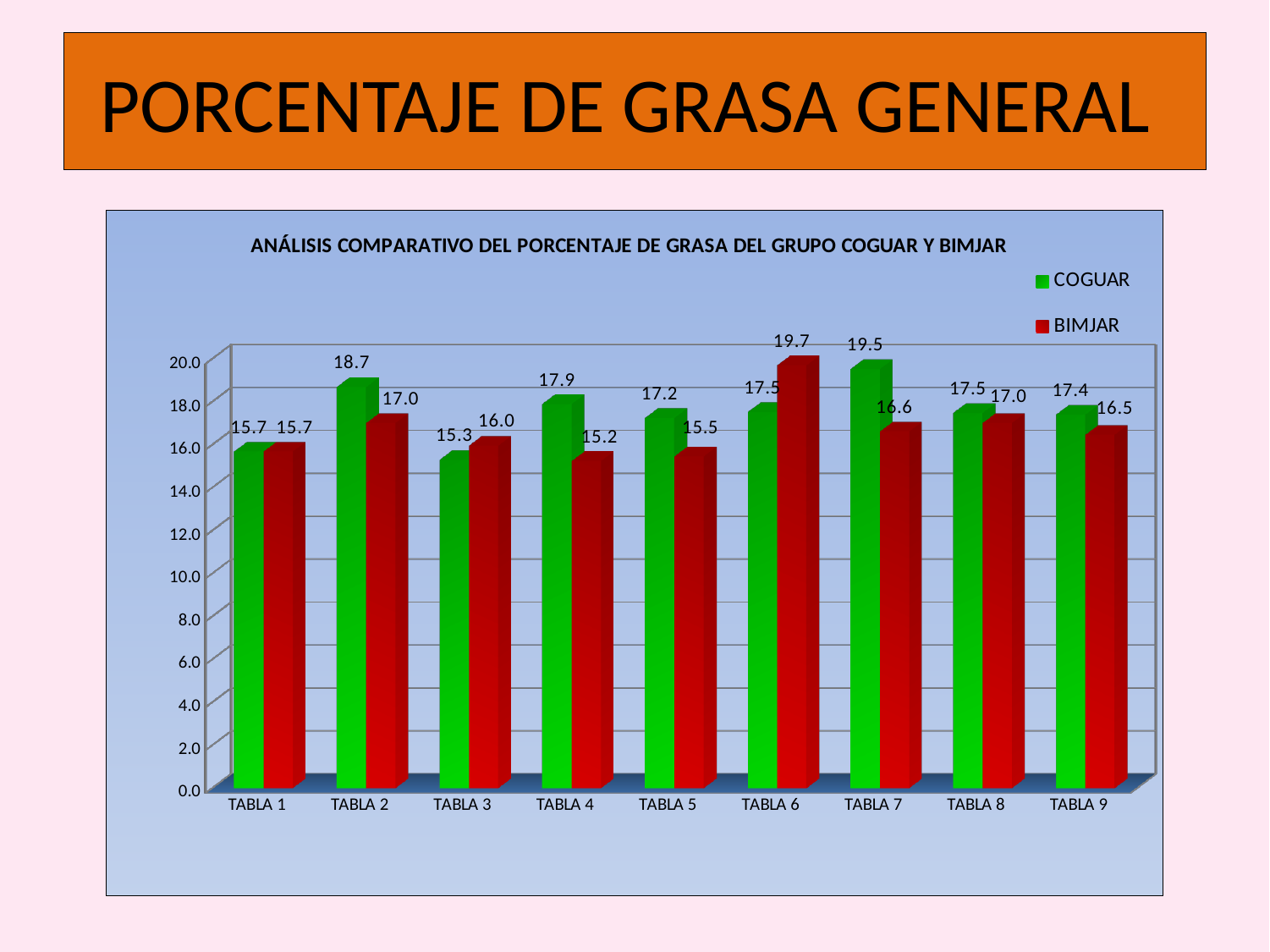
For TABLA 3, which series has the larger value, COGUAR or BIMJAR? BIMJAR What is the BIMJAR value for TABLA 4? 15.2 How many series does the legend list? 2 What is the difference between the COGUAR and BIMJAR values for TABLA 4? 2.7 What is the COGUAR value for TABLA 9? 17.4 Which category has the lowest BIMJAR value? TABLA 4 What type of chart is shown on the slide? Bar chart How many categories are shown on the x axis? 9 Which category has the highest COGUAR value? TABLA 7 What is the BIMJAR value for TABLA 6? 19.7 Which category has the lowest COGUAR value? TABLA 3 What is the COGUAR value for TABLA 2? 18.7